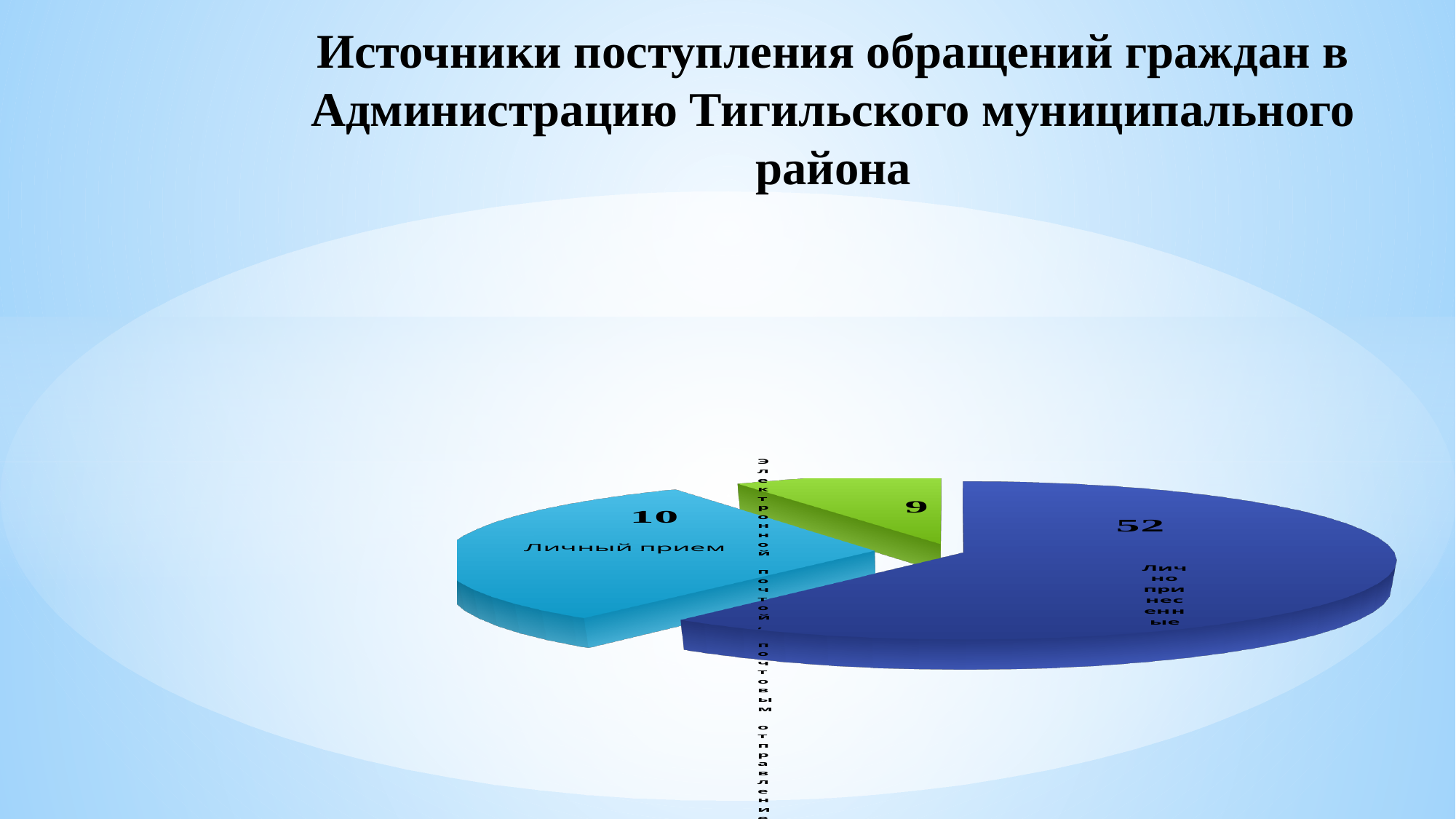
How many slices does the pie chart have? 3 What is the total of all the values shown on the pie chart? 71 What is the difference between the value for "Личный прием" and the value on the green slice? 1 Which is larger: the value for "Личный прием" or the value on the green slice? Личный прием What is the value for "Лично принесенные"? 52 What is the smallest value printed on the pie chart? 9 Which category has the largest slice of the pie chart? Лично принесенные What colour is the slice for "Лично принесенные"? Dark blue What kind of chart is shown on the slide? Pie chart What is the value for "Личный прием"? 10 What value is printed on the green slice of the pie chart? 9 What is the difference between the values for "Лично принесенные" and "Личный прием"? 42